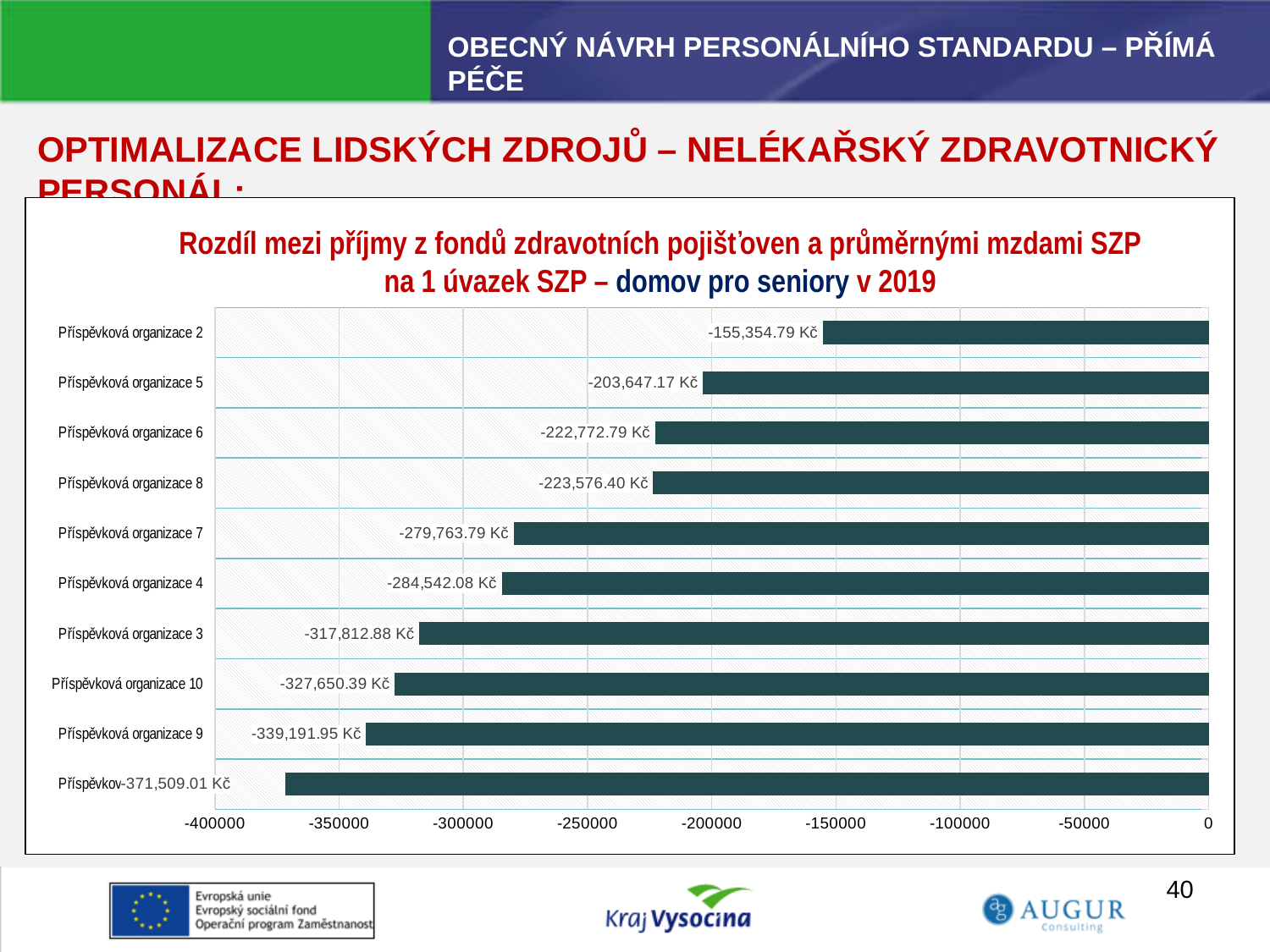
What year does the chart title refer to? 2019 Is the value for Příspěvková organizace 7 greater or less than -250000? less What type of chart is shown on the slide? bar chart Which category has the highest (least negative) value? Příspěvková organizace 2 How many categories are shown in the chart? 10 Which has the larger (less negative) value, Příspěvková organizace 3 or Příspěvková organizace 4? Příspěvková organizace 4 What is the difference between the values for Příspěvková organizace 2 and Příspěvková organizace 5? 48,292.38 Kč What is the value for Příspěvková organizace 10? -327,650.39 Kč What is the value for Příspěvková organizace 2? -155,354.79 Kč What is the value for Příspěvková organizace 7? -279,763.79 Kč What is the lowest value shown in the chart? -371,509.01 Kč What is the value for Příspěvková organizace 9? -339,191.95 Kč